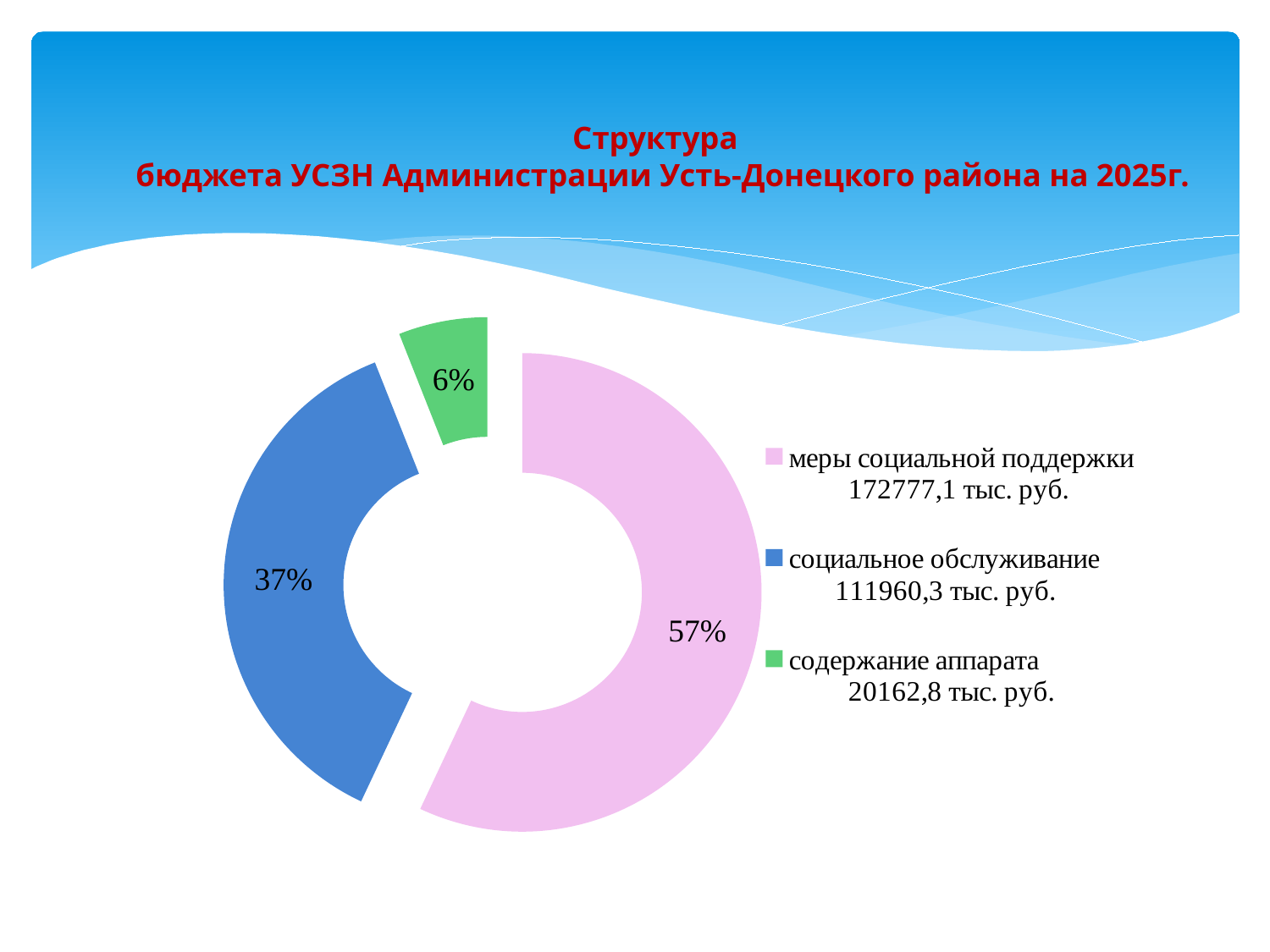
What share of the budget does "социальное обслуживание" account for? 37% What amount is shown in the legend for "содержание аппарата"? 20162,8 тыс. руб. Which category has the smallest share of the budget? содержание аппарата What type of chart is shown on the slide? Doughnut (pie) chart By how many percentage points does the share of "меры социальной поддержки" exceed that of "социальное обслуживание"? 20 percentage points What amount is shown in the legend for "меры социальной поддержки"? 172777,1 тыс. руб. What amount is shown in the legend for "социальное обслуживание"? 111960,3 тыс. руб. What share of the budget does "меры социальной поддержки" account for? 57% How many categories does the chart show? 3 What share of the budget does "содержание аппарата" account for? 6% Which is larger: the share for "социальное обслуживание" or for "содержание аппарата"? социальное обслуживание Which category has the largest share of the budget? меры социальной поддержки